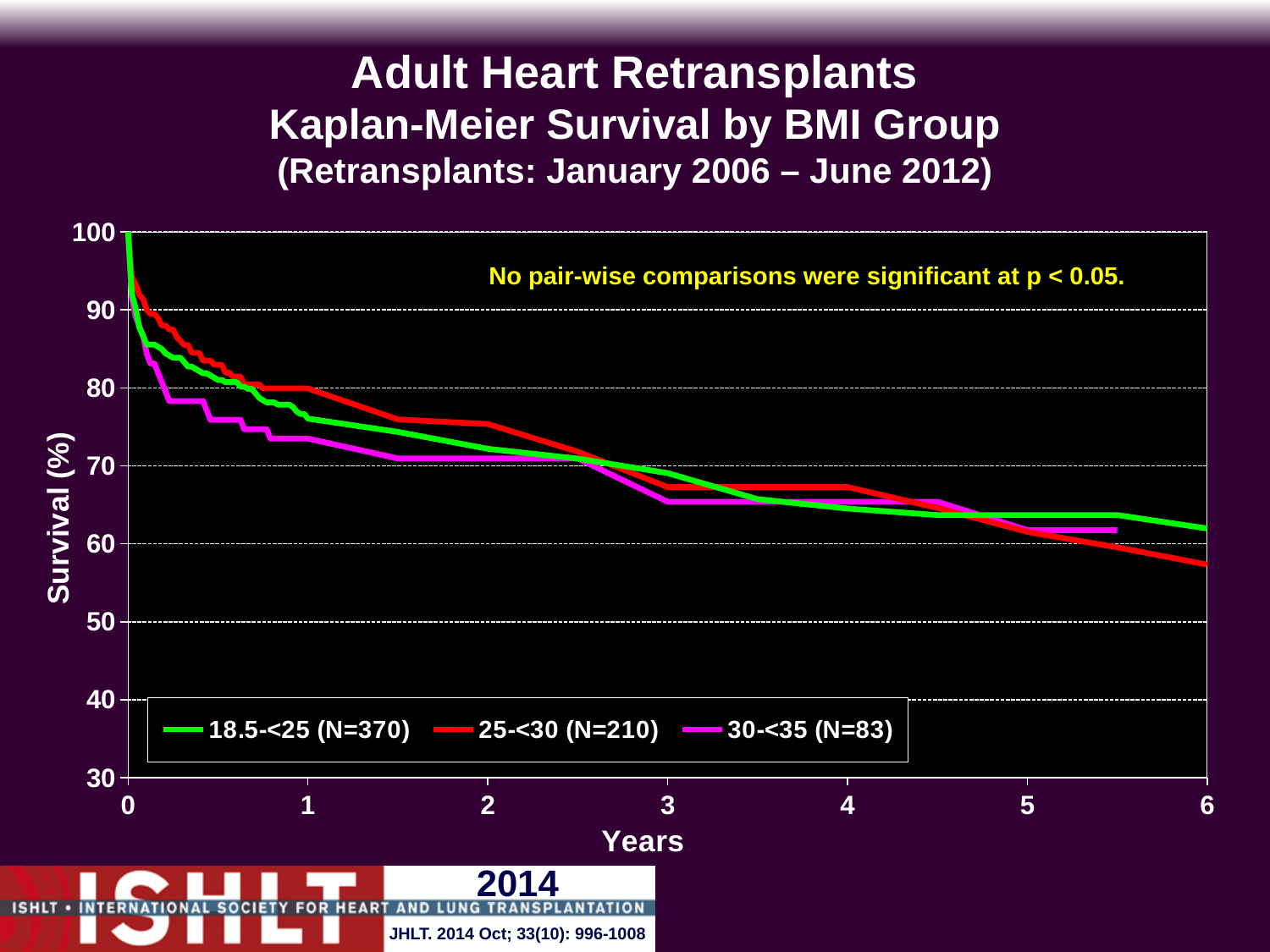
Is the survival value for the 18.5-<25 group at year 6 greater or less than 60? greater Is the survival value for the 30-<35 group at year 3 greater or less than 70? less What kind of chart is shown on the slide? line chart How many series does the legend list? 3 Is the survival value for the 18.5-<25 group at year 1 greater or less than 70? greater What is the label of the y axis? Survival (%) At year 1, which group has higher survival: 25-<30 or 30-<35? 25-<30 Do the survival curves rise or fall as years increase? fall At year 6, which group has higher survival: 18.5-<25 or 25-<30? 18.5-<25 What is the N for the 18.5-<25 BMI group shown in the legend? N=370